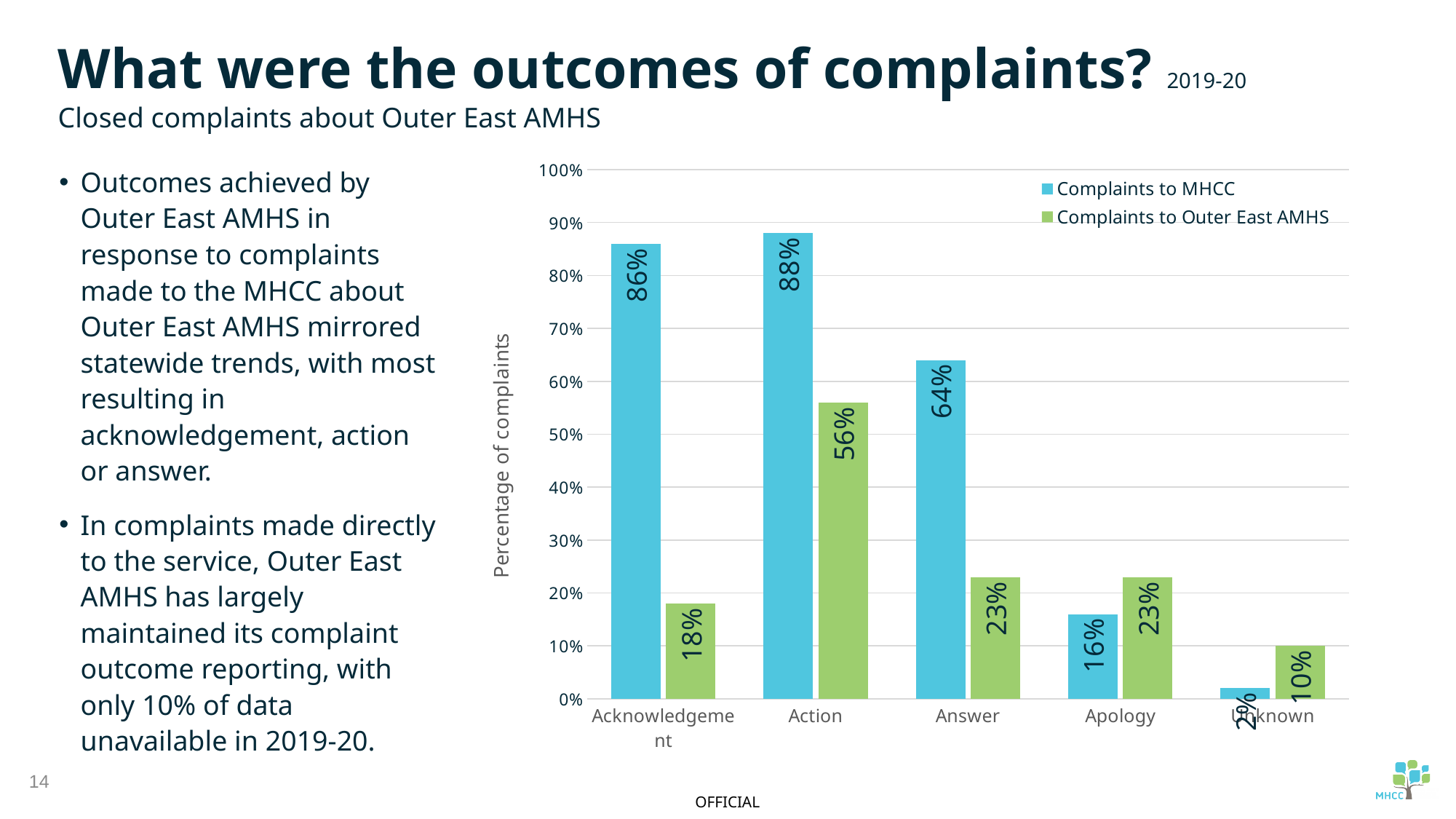
What percentage of complaints to Outer East AMHS resulted in Action? 56% Is the value for Unknown in the Complaints to MHCC series greater or less than 10%? less For Apology, which series has the larger value: Complaints to MHCC or Complaints to Outer East AMHS? Complaints to Outer East AMHS What percentage of complaints to MHCC resulted in Acknowledgement? 86% Which outcome category has the highest value for Complaints to MHCC? Action What is the value for Apology in the Complaints to Outer East AMHS series? 23% How many series does the legend list? 2 What is the value for Answer in the Complaints to MHCC series? 64% What type of chart is shown on the slide? Bar chart Which outcome category has the lowest value for Complaints to Outer East AMHS? Unknown How many outcome categories are shown on the x axis? 5 For Action, how many percentage points higher is Complaints to MHCC than Complaints to Outer East AMHS? 32 percentage points